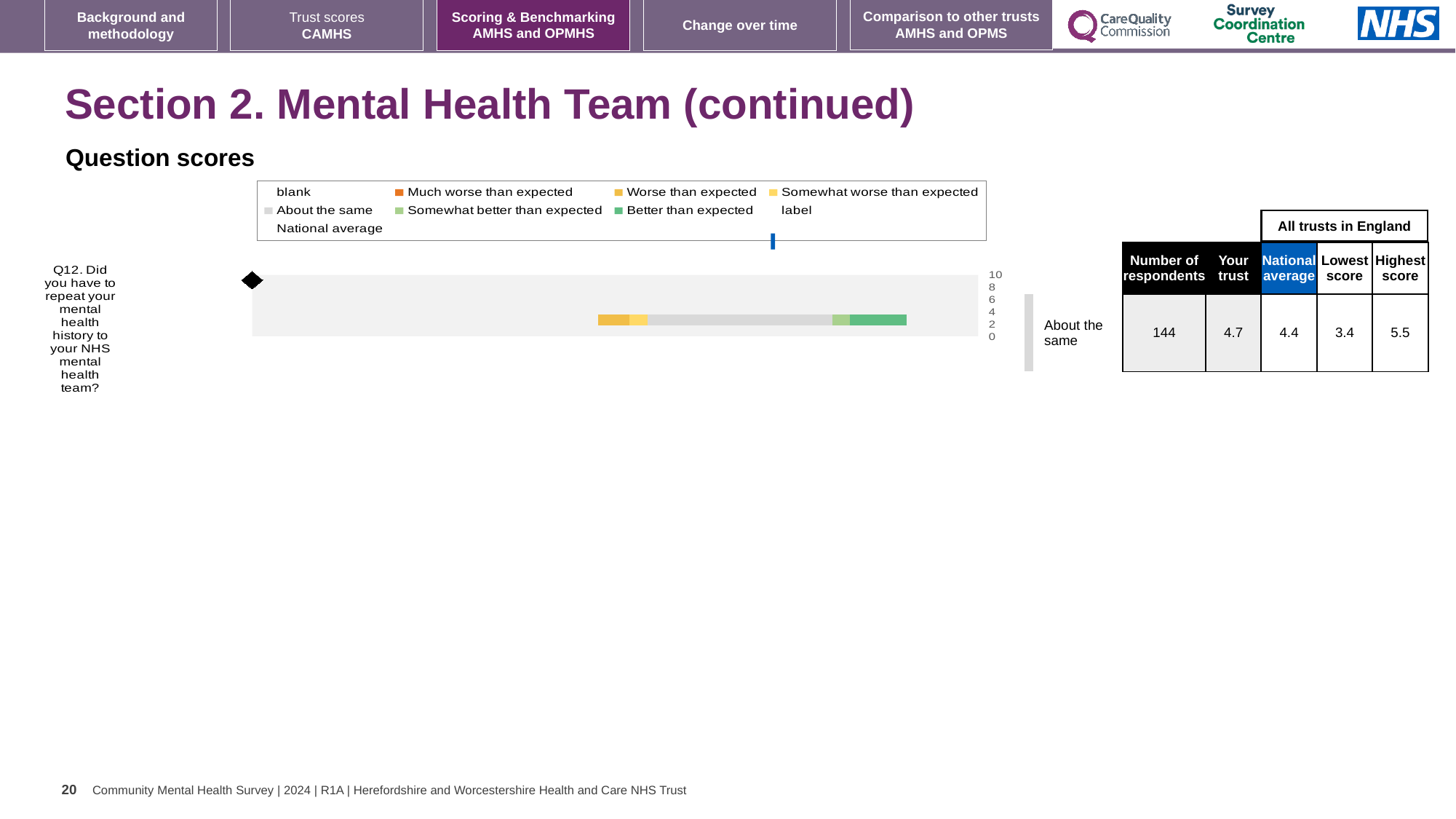
What is the 'Your trust' score for Q12? 4.7 What kind of chart is used to show the Q12 question score? bar chart How many survey questions are plotted on the chart? 1 What is the difference between the 'Your trust' score and the national average for Q12? 0.3 What is the highest score among all trusts in England for Q12? 5.5 Which benchmark category is shown for Q12 (Did you have to repeat your mental health history to your NHS mental health team?)? About the same What is the difference between the highest score and the lowest score for Q12? 2.1 For Q12, is the 'Your trust' score higher or lower than the national average? higher What is the number of respondents for Q12? 144 What is the lowest score among all trusts in England for Q12? 3.4 What is the national average score for Q12? 4.4